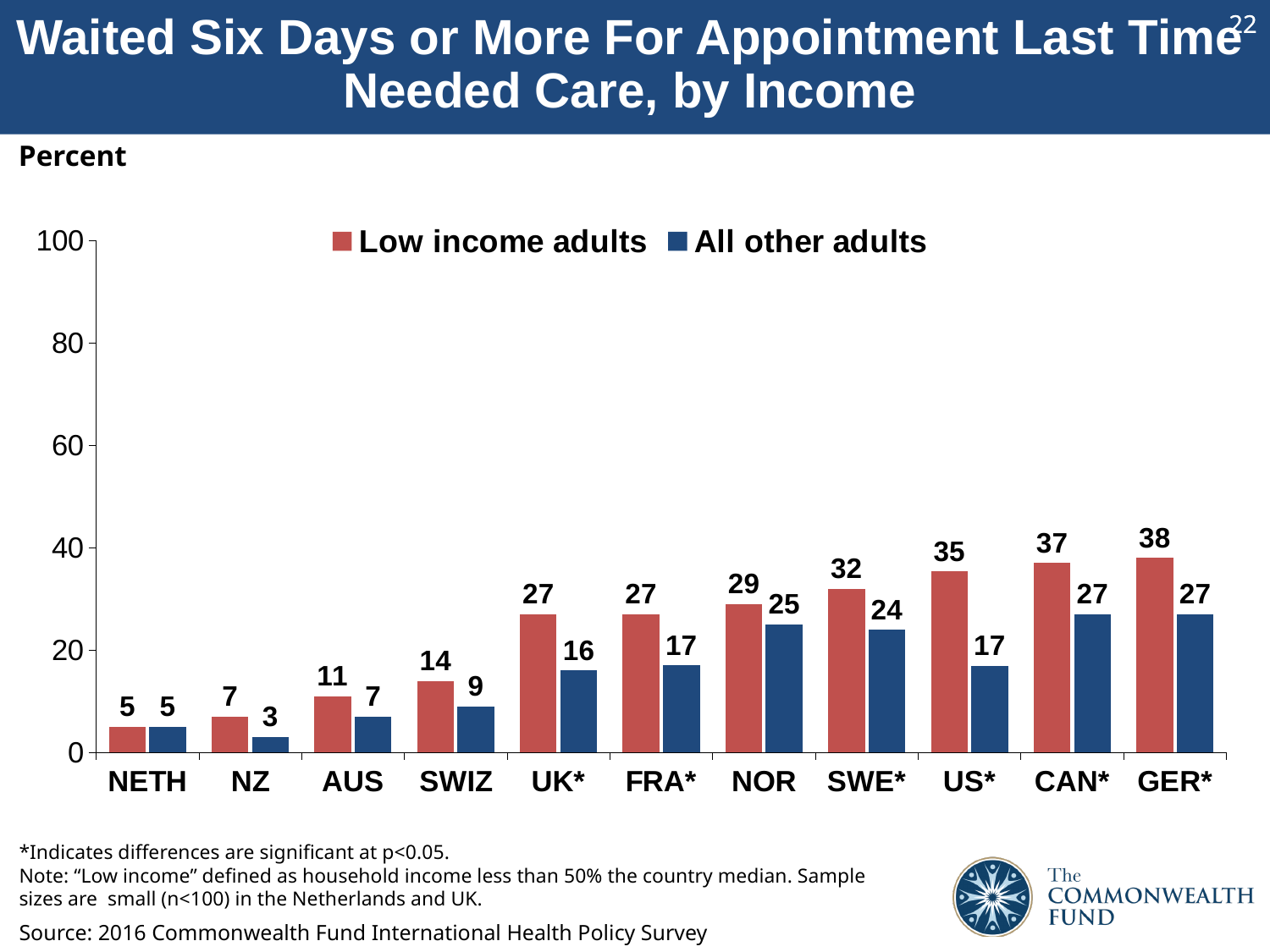
What is the value for All other adults in NZ? 3 Which country has the lowest value for All other adults? NZ How many series does the legend list? 2 What is the value for Low income adults in GER*? 38 How many countries are shown on the x axis? 11 What kind of chart is shown on the slide? Bar chart What is the difference between Low income adults and All other adults in US*? 18 Which country has the highest value for Low income adults? GER* Which is larger in SWE*: the value for Low income adults or for All other adults? Low income adults What is the value for All other adults in NOR? 25 Is the value for Low income adults in CAN* greater or less than 20? greater Which colour represents Low income adults in the chart? Red